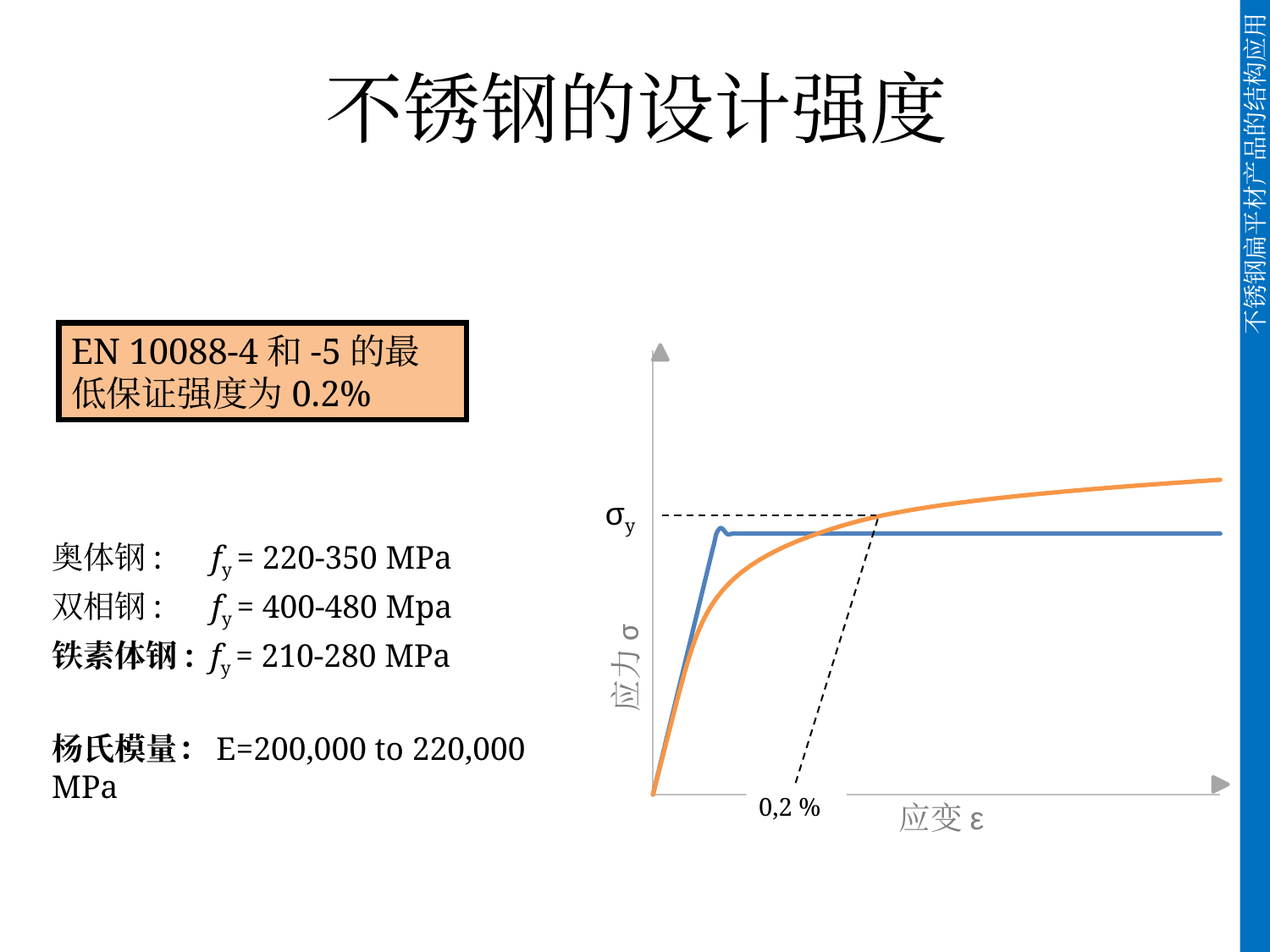
At the right-hand end of the chart, which curve is higher, the orange one or the blue one? orange Which curve rises more steeply at the start, the blue one or the orange one? blue How many curves are plotted on the stress-strain chart? 2 What strain value is marked on the x axis where the dashed offset line meets it? 0,2 % What kind of chart is shown on the slide? line chart What is the label of the x axis of the chart? 应变 ε What label is shown on the y axis at the horizontal dashed line? σy After its initial steep rise, does the blue curve keep rising, fall, or stay level? stays level What is the label of the y axis of the chart? 应力 σ Does the orange curve rise or fall as strain increases along the x axis? rises